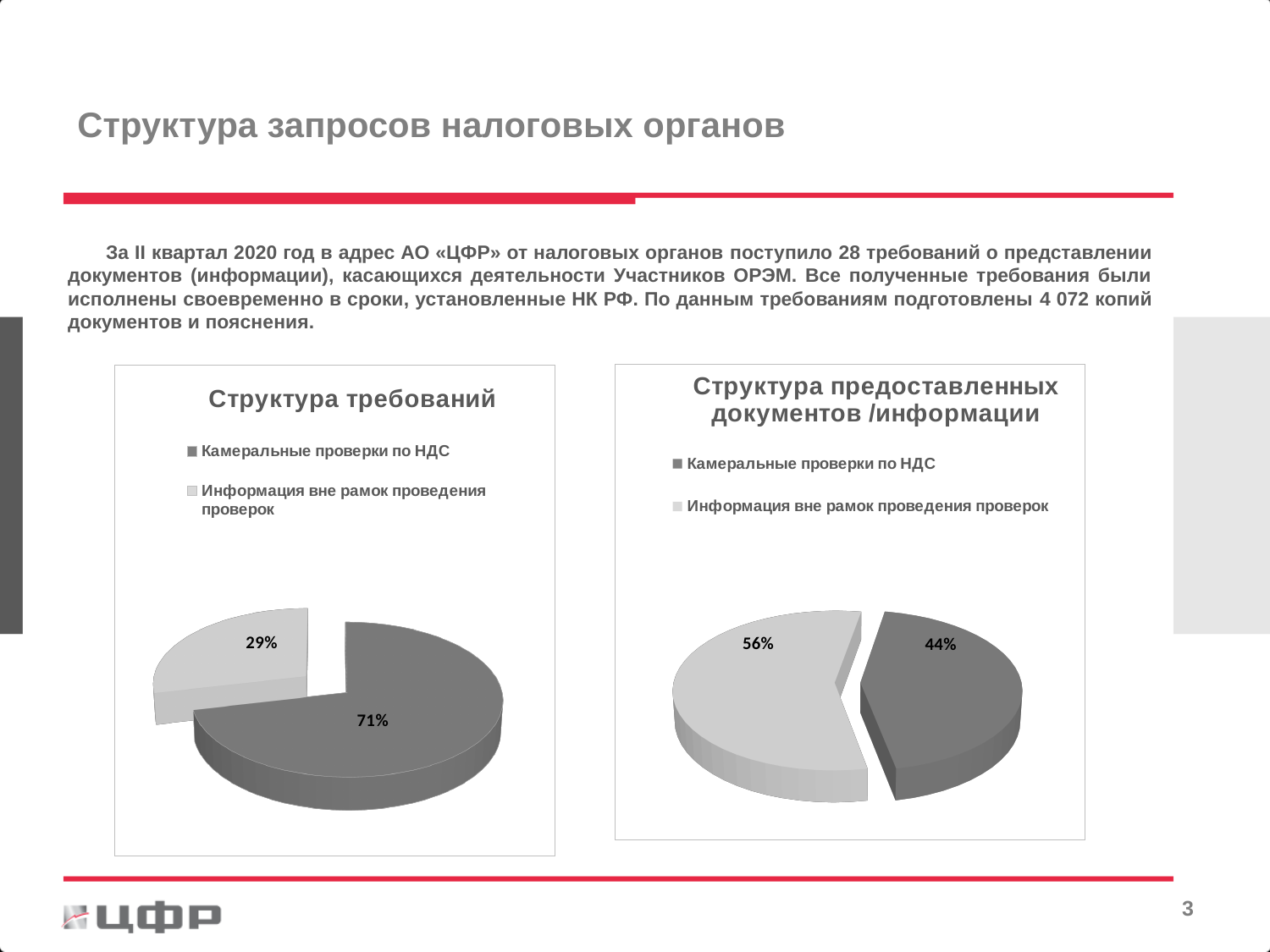
In the chart titled «Структура требований», which category has the largest slice? Камеральные проверки по НДС In the chart titled «Структура требований», what is the difference in percentage points between the two slices? 42 Which is larger: the share of «Камеральные проверки по НДС» in the left chart or in the right chart? Left chart (71%) In the chart titled «Структура предоставленных документов /информации», which colour is used for «Информация вне рамок проведения проверок»? Light grey In the chart titled «Структура предоставленных документов /информации», what share is shown for «Камеральные проверки по НДС»? 44% In the chart titled «Структура предоставленных документов /информации», what is the difference in percentage points between the two slices? 12 How many categories does the legend of the chart titled «Структура требований» list? 2 What type of chart is used on the left side of the slide? Pie chart In the chart titled «Структура требований», what share is shown for «Камеральные проверки по НДС»? 71% In the chart titled «Структура предоставленных документов /информации», which category has the smallest slice? Камеральные проверки по НДС In the chart titled «Структура требований», what share is shown for «Информация вне рамок проведения проверок»? 29% In the chart titled «Структура предоставленных документов /информации», what share is shown for «Информация вне рамок проведения проверок»? 56%